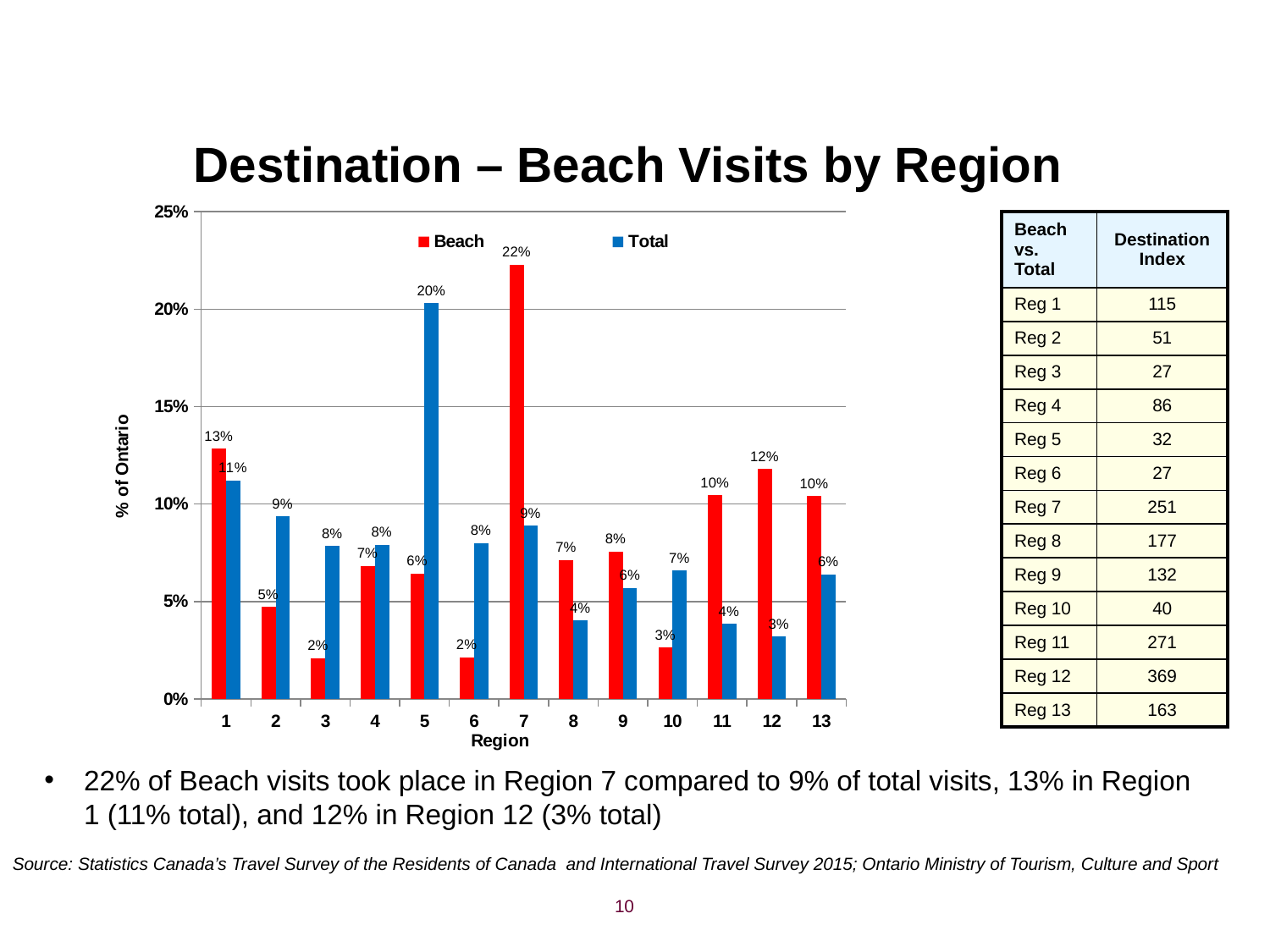
What is the Beach value for Region 7? 22% Which region has the highest Beach value? Region 7 How many series does the chart legend list? 2 For Region 12, which is larger, the Beach value or the Total value? Beach Which region has the highest Total value? Region 5 What type of chart is shown on the slide? Bar chart What is the Total value for Region 5? 20% What is the difference between the Beach and Total values for Region 7? 13 percentage points What is the Beach value for Region 12? 12% How many regions are shown on the x axis of the chart? 13 Which region has the lowest Total value? Region 12 What is the Total value for Region 1? 11%